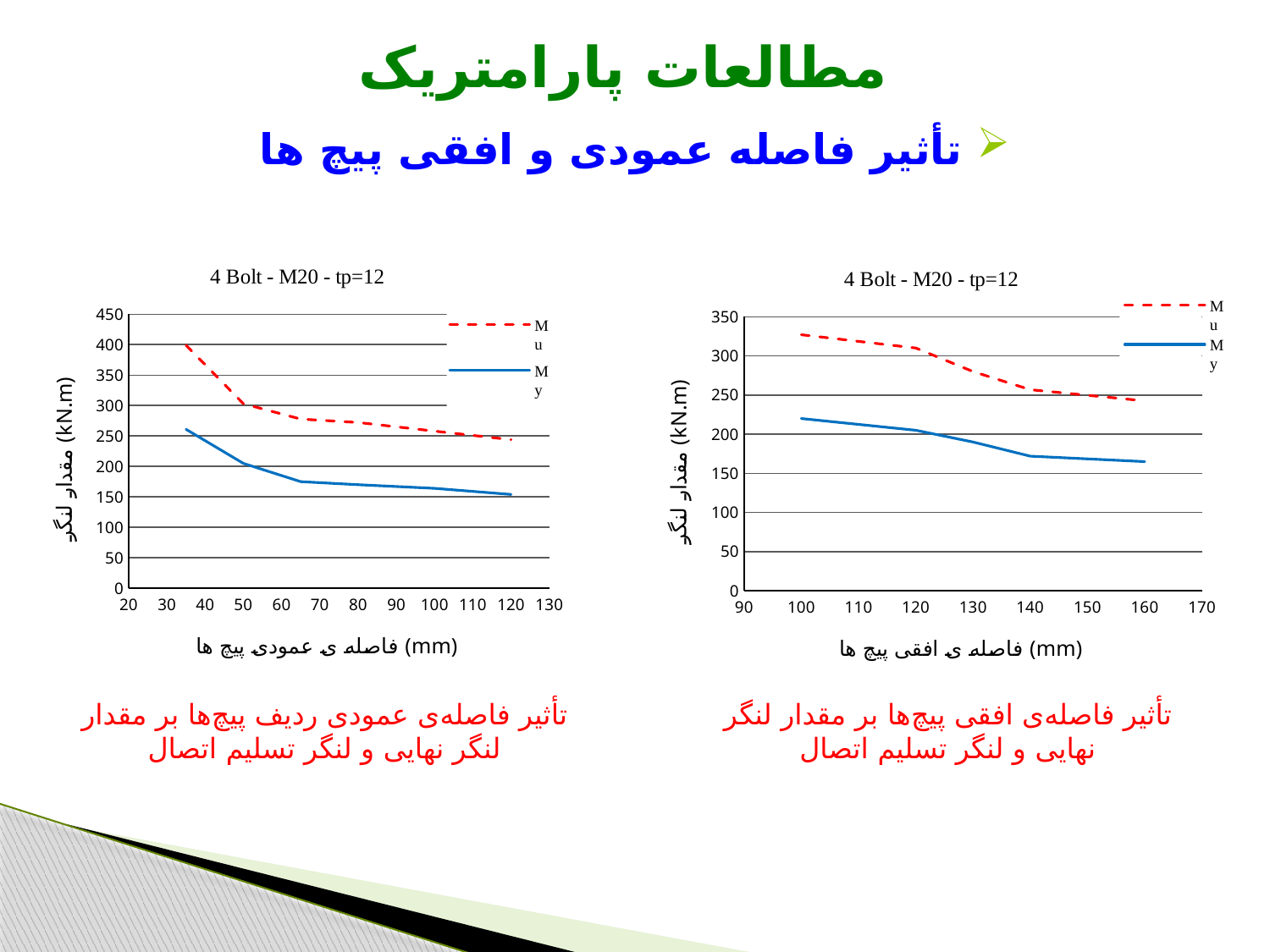
What is the title of the right chart? 4 Bolt - M20 - tp=12 In the right chart, does the My series rise or fall as the horizontal bolt spacing increases along the x axis? fall In the right chart, which series has the larger value at a horizontal spacing of 140 mm, Mu or My? Mu What kind of chart is the left chart on the slide? line chart In the left chart, is the My value at a vertical spacing of 120 mm greater or less than 200? less In the left chart, which series is drawn as a red dashed line? Mu In the left chart, does the Mu series rise or fall as the vertical bolt spacing increases along the x axis? fall In the left chart, is the Mu value at a vertical spacing of 50 mm greater or less than 250? greater How many series does the legend of the right chart list? 2 In the right chart, is the Mu value at a horizontal spacing of 100 mm greater or less than 300? greater In the left chart, which series has the larger value at a vertical spacing of 100 mm, Mu or My? Mu